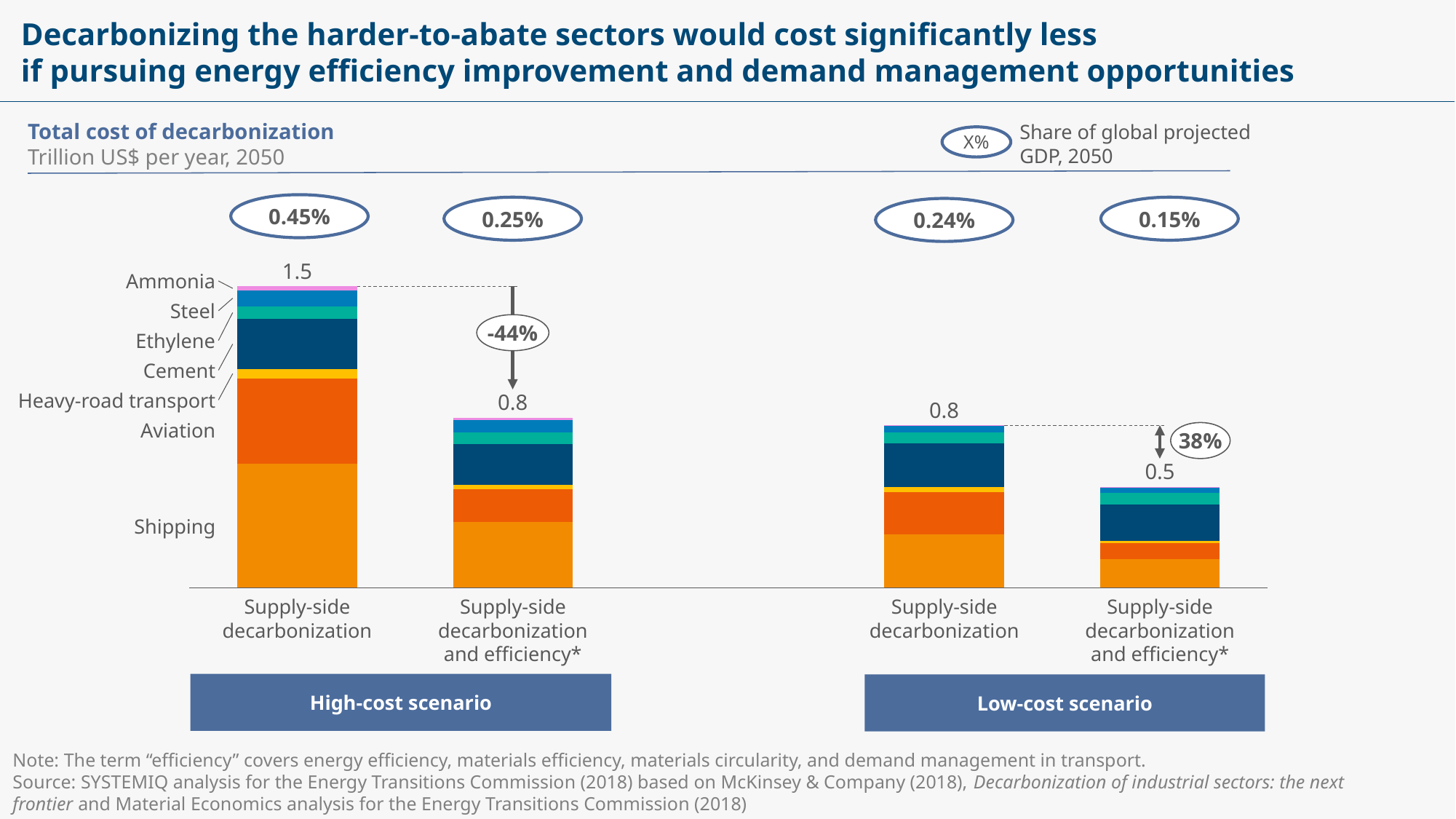
What is the difference in total cost between supply-side decarbonization and supply-side decarbonization and efficiency in the high-cost scenario? 0.7 What is the total cost of decarbonization for supply-side decarbonization in the high-cost scenario? 1.5 How many sectors are stacked in each bar of the chart? 7 By what percentage does the cost fall from supply-side decarbonization to supply-side decarbonization and efficiency in the high-cost scenario, as labelled on the chart? -44% Which sector forms the bottom segment of each stacked bar? Shipping What share of global projected GDP in 2050 does supply-side decarbonization represent in the high-cost scenario? 0.45% What type of chart is shown on the slide? Stacked bar chart What is the total cost of decarbonization for supply-side decarbonization and efficiency in the high-cost scenario? 0.8 What share of global projected GDP in 2050 does supply-side decarbonization and efficiency represent in the low-cost scenario? 0.15% What is the total cost of decarbonization for supply-side decarbonization and efficiency in the low-cost scenario? 0.5 Which bar has the lowest total cost of decarbonization? Supply-side decarbonization and efficiency, low-cost scenario Which bar has the highest total cost of decarbonization? Supply-side decarbonization, high-cost scenario